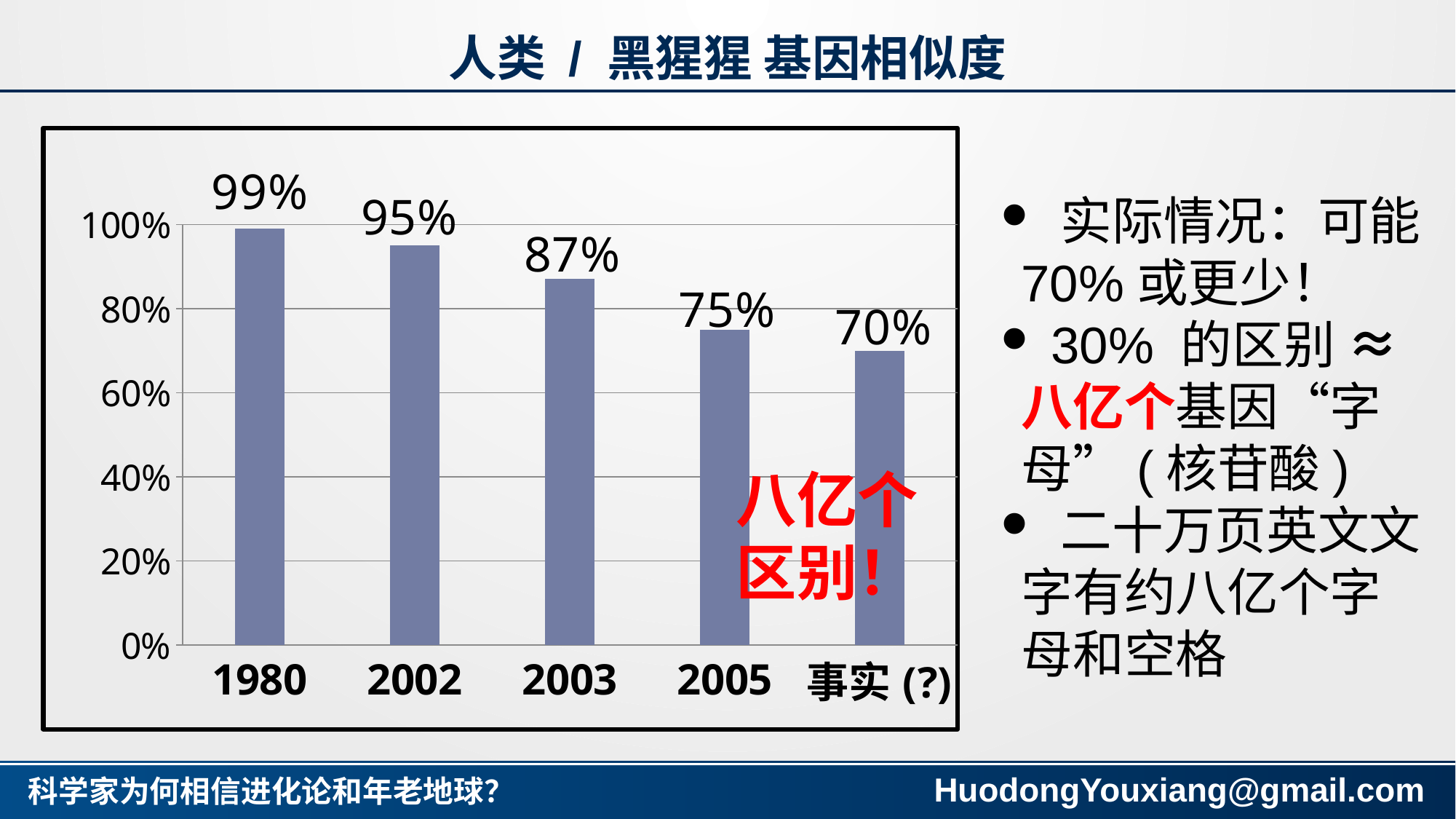
Do the values rise or fall from left to right along the x axis? fall Is the value for 2005 greater or less than 80%? less What is the difference between the values for 2002 and 2003? 8% What is the value for 1980? 99% What kind of chart is shown on the slide? bar chart Which category has the lowest value? 事实 (?) Which category has the highest value? 1980 How many categories are shown on the x axis? 5 Which is larger, the value for 2002 or the value for 2005? 2002 What is the difference between the values for 1980 and 2005? 24% What is the value for 事实 (?)? 70% What is the value for 2003? 87%